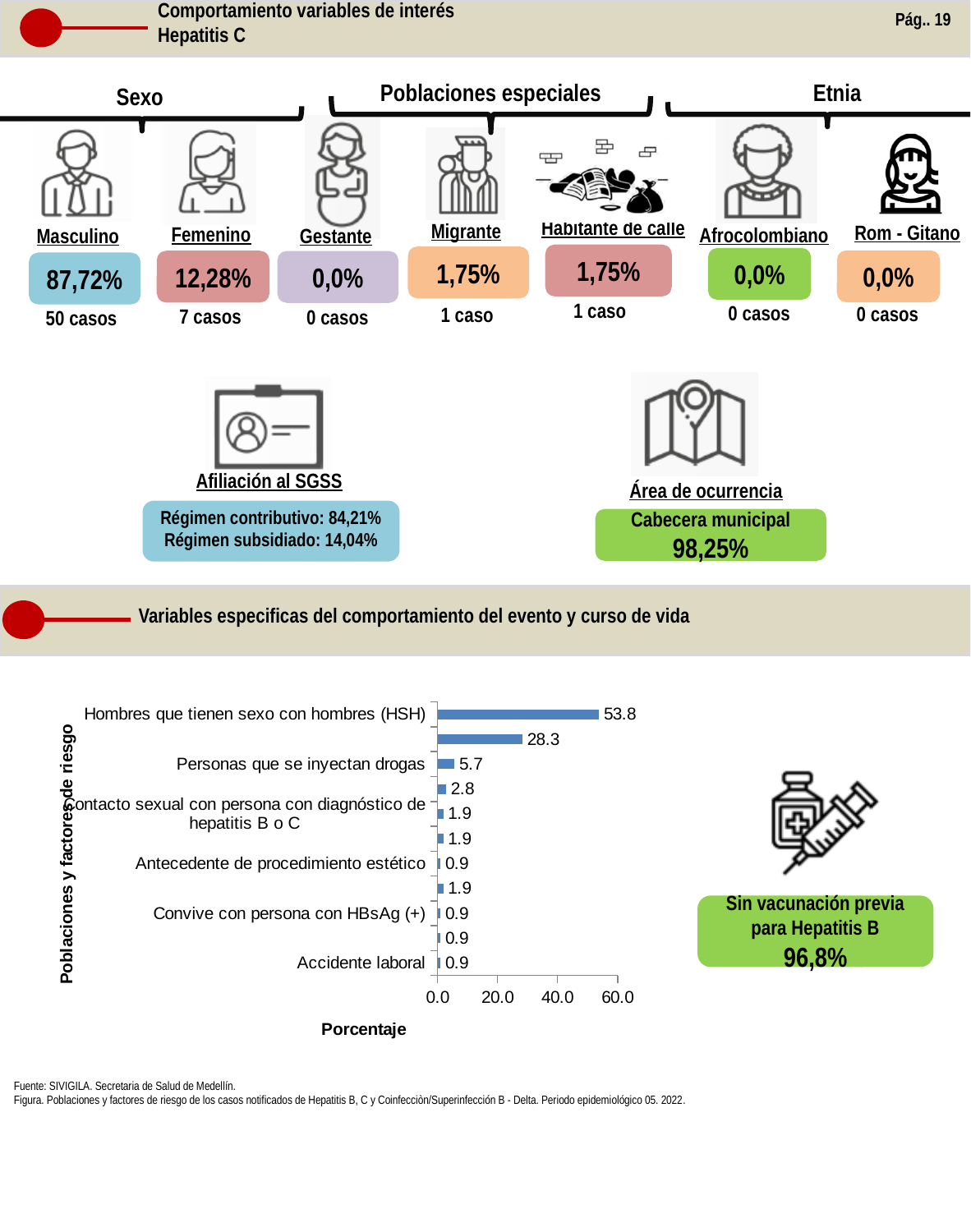
What is the value for Personas que se inyectan drogas? 5.7 What is the difference between the values for Hombres que tienen sexo con hombres (HSH) and Personas que se inyectan drogas? 48.1 Which is larger: the value for Personas que se inyectan drogas or the value for Convive con persona con HBsAg (+)? Personas que se inyectan drogas Is the value for Hombres que tienen sexo con hombres (HSH) greater or less than 40.0? greater What is the value for Contacto sexual con persona con diagnóstico de hepatitis B o C? 1.9 How many bars are plotted in the bar chart? 11 What is the value for Antecedente de procedimiento estético? 0.9 What kind of chart is shown at the bottom of the slide? bar chart What is the title of the horizontal axis of the bar chart? Porcentaje What is the value for Hombres que tienen sexo con hombres (HSH)? 53.8 Which category has the highest value in the bar chart? Hombres que tienen sexo con hombres (HSH) What is the value for Accidente laboral? 0.9